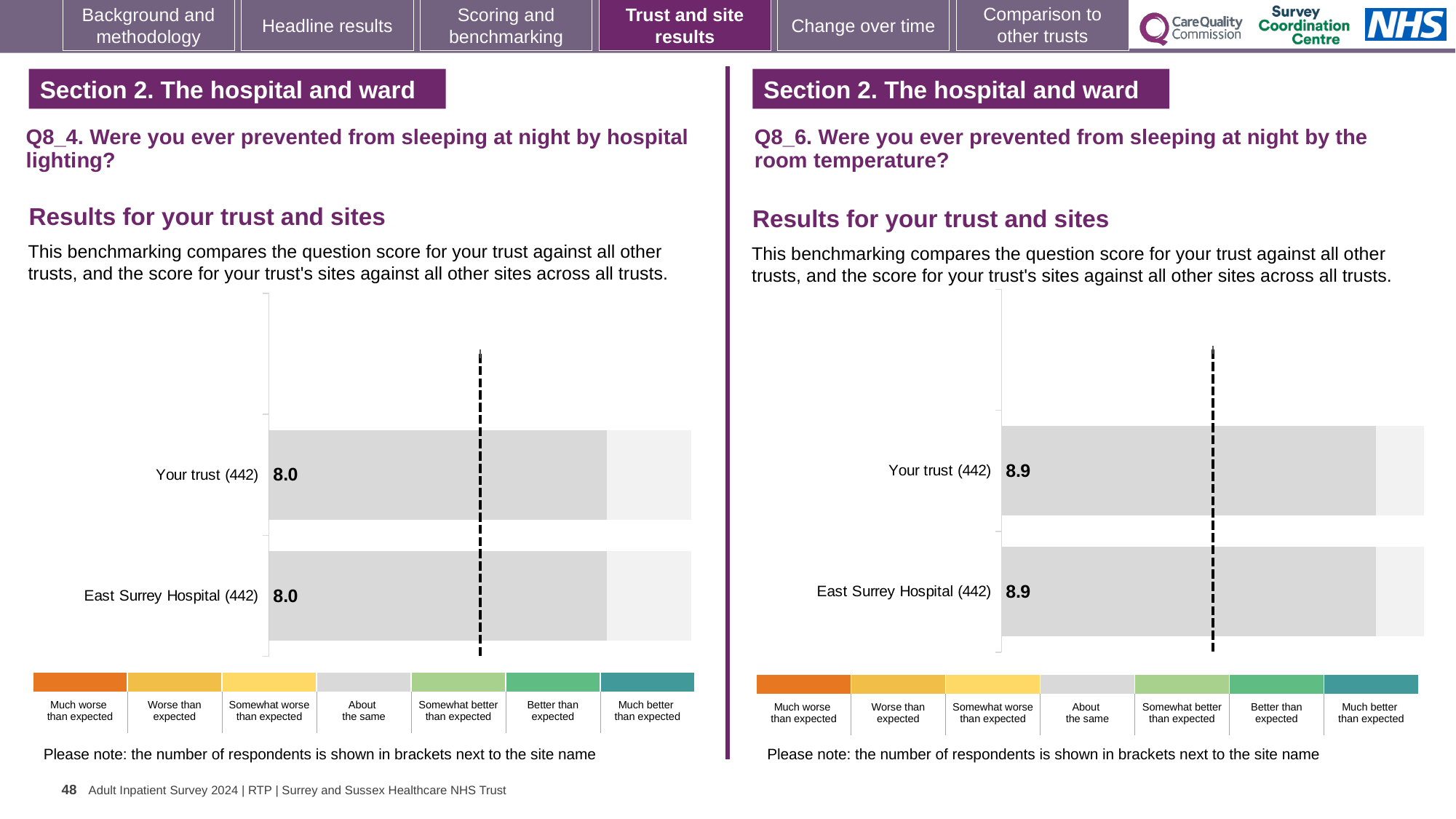
In the Q8_6 chart (room temperature), what is the score for East Surrey Hospital? 8.9 How many respondents are shown in brackets for Your trust in the Q8_6 chart (room temperature)? 442 In the Q8_4 chart (hospital lighting), what is the difference between the Your trust score and the East Surrey Hospital score? 0.0 How many bars are plotted in the Q8_4 chart (hospital lighting)? 2 In the Q8_6 chart (room temperature), what is the difference between the Your trust score and the East Surrey Hospital score? 0.0 In the Q8_4 chart (hospital lighting), which benchmark category does the grey colour of the bars correspond to in the key? About the same How many categories are listed in the colour key below the Q8_6 chart (room temperature)? 7 In the Q8_6 chart (room temperature), what is the score for Your trust? 8.9 What type of chart is used for the Q8_4 results (hospital lighting)? Bar chart How many bars are plotted in the Q8_6 chart (room temperature)? 2 In the Q8_4 chart (hospital lighting), what is the score for East Surrey Hospital? 8.0 In the Q8_4 chart (hospital lighting), what is the score for Your trust? 8.0